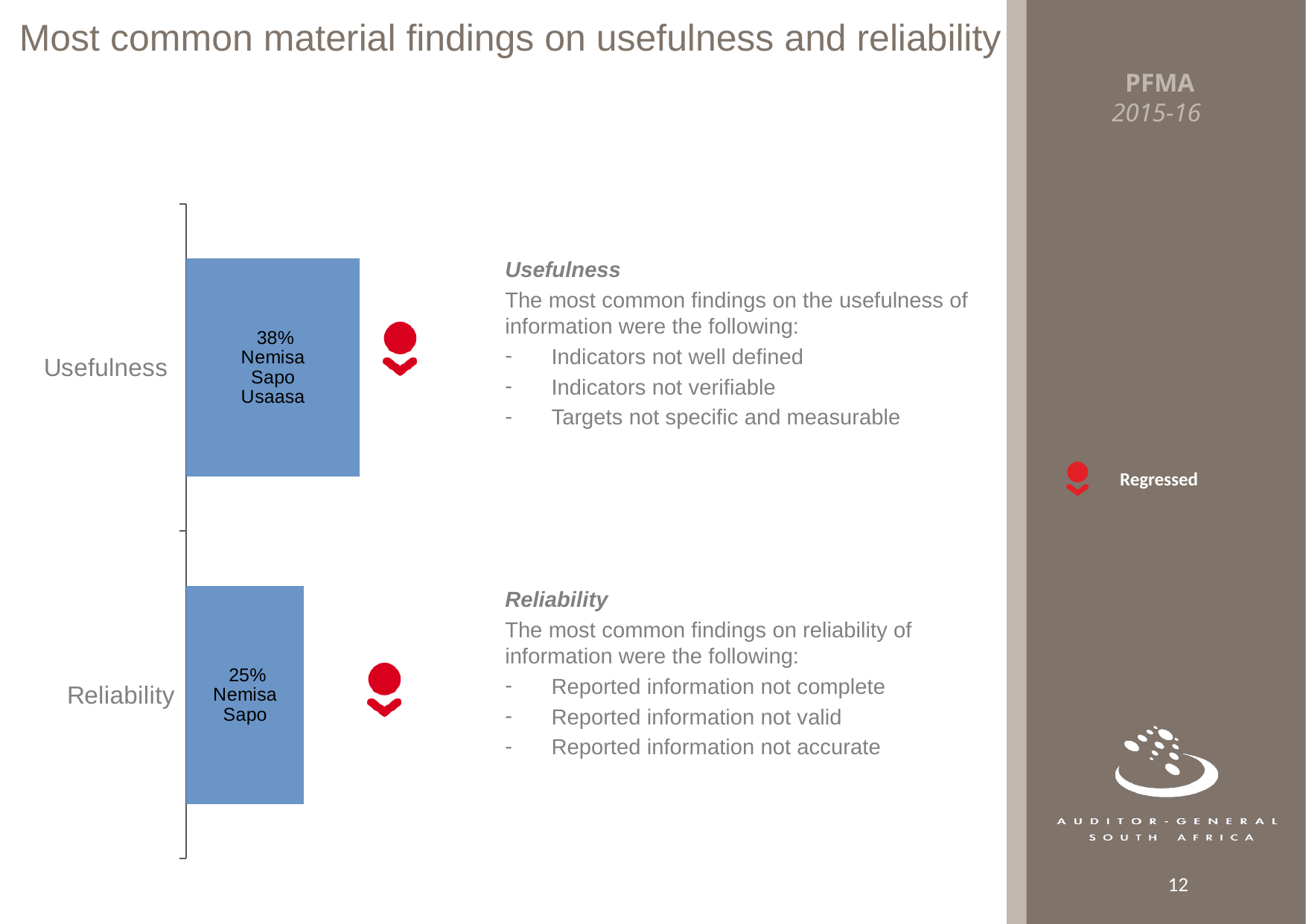
What is the value shown for Reliability? 25% What is the difference between the Usefulness value and the Reliability value? 13% Which entities are listed inside the Usefulness bar? Nemisa, Sapo, Usaasa How many categories are plotted in the chart? 2 Is the value for Reliability larger or smaller than the value for Usefulness? smaller Which category has the lowest value? Reliability What kind of chart is shown on the slide? bar chart What is the value shown for Usefulness? 38% Which category has the higher value, Usefulness or Reliability? Usefulness Which entities are listed inside the Reliability bar? Nemisa, Sapo